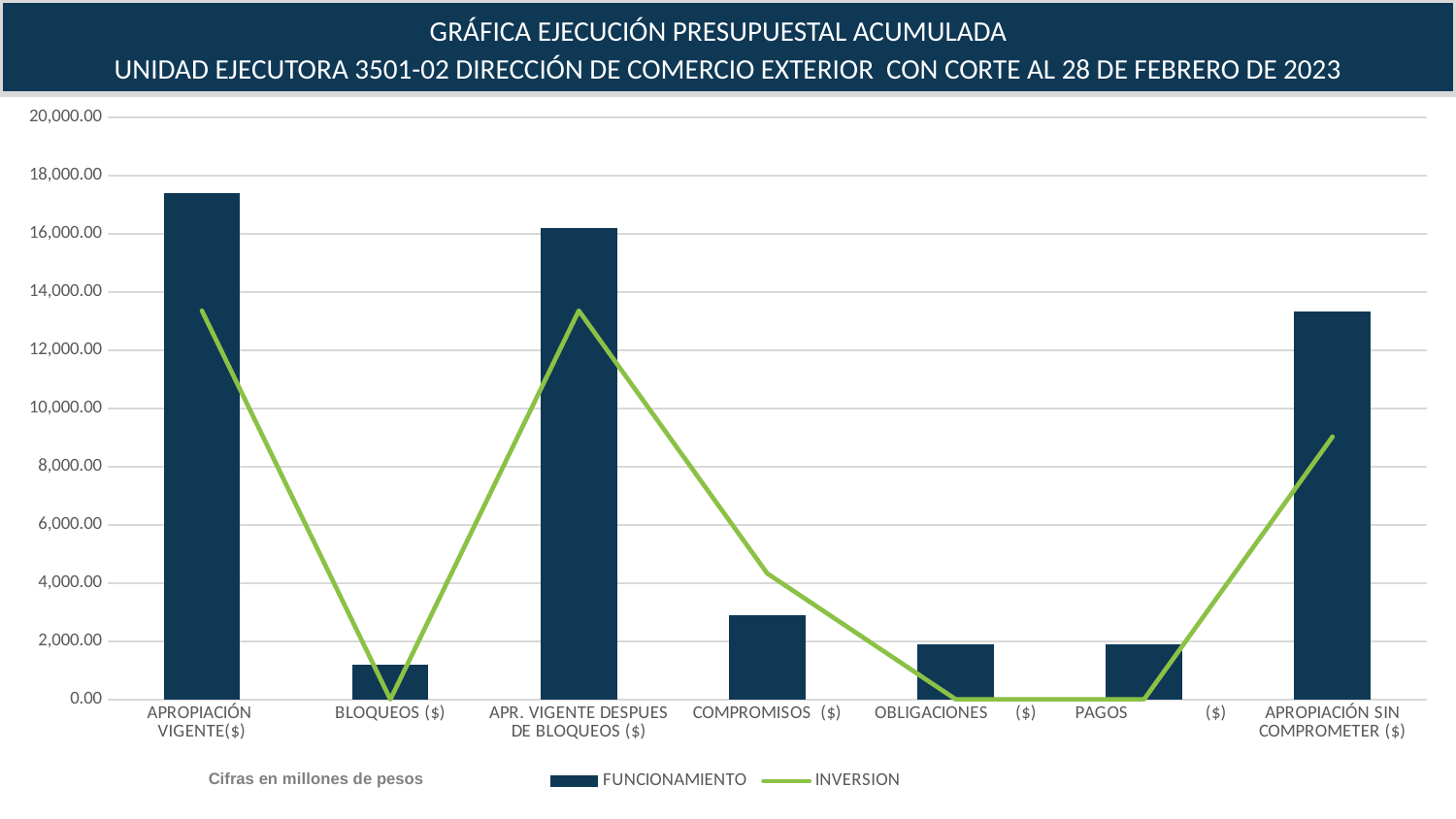
Which series is drawn as a green line? INVERSION For APROPIACIÓN SIN COMPROMETER ($), which series has the larger value, FUNCIONAMIENTO or INVERSION? FUNCIONAMIENTO For COMPROMISOS ($), which series has the larger value, FUNCIONAMIENTO or INVERSION? INVERSION How many categories are shown on the x axis? 7 How many series does the legend list? 2 Which category has the highest FUNCIONAMIENTO value? APROPIACIÓN VIGENTE($) Is the INVERSION value for COMPROMISOS ($) greater or less than 6,000.00? less Is the FUNCIONAMIENTO value for BLOQUEOS ($) greater or less than 2,000.00? less Is the INVERSION value for APROPIACIÓN SIN COMPROMETER ($) greater or less than 8,000.00? greater What kind of chart is shown on the slide? A combined bar and line chart Which category has the lowest FUNCIONAMIENTO value? BLOQUEOS ($)